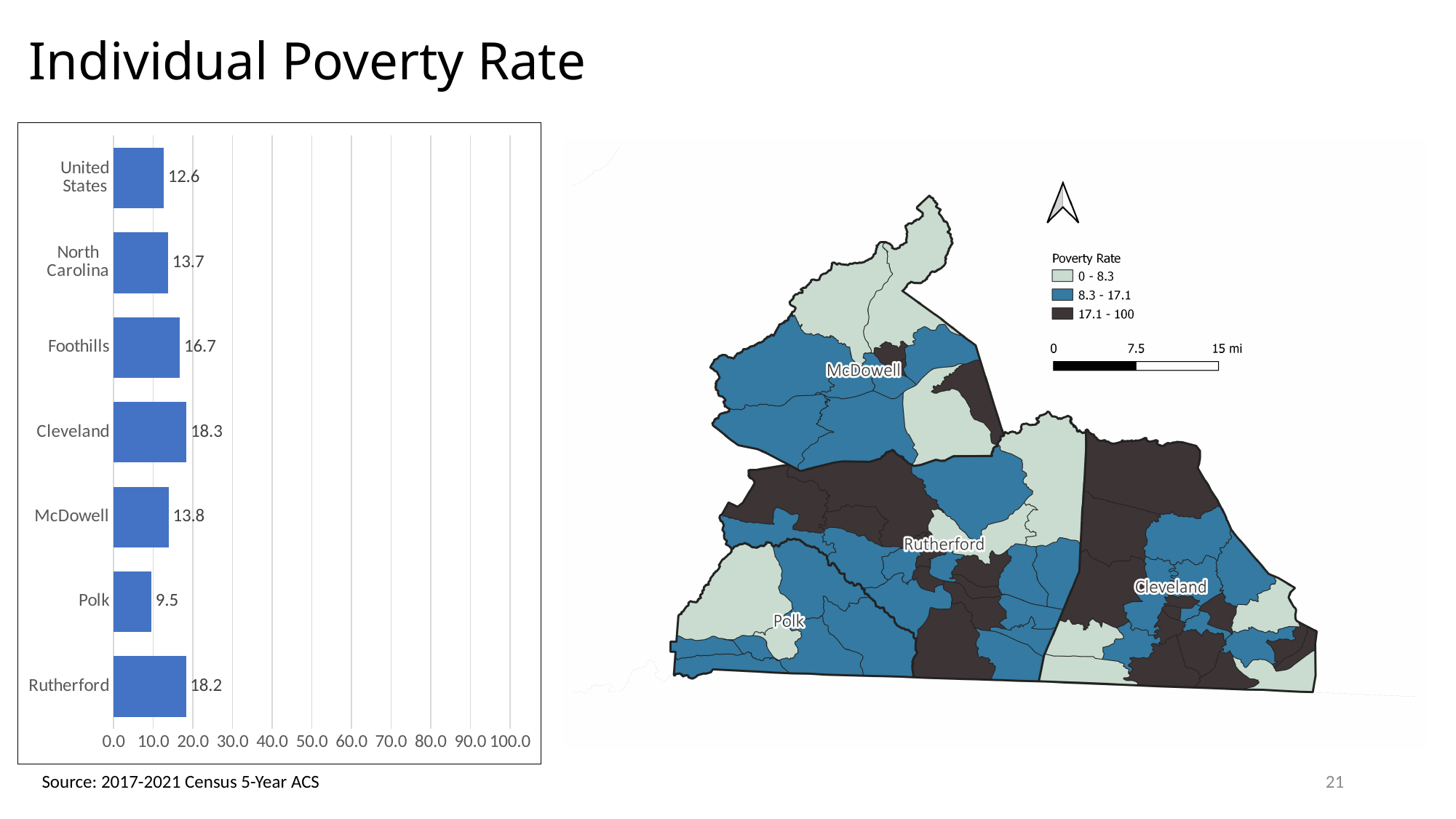
How many categories are shown in the bar chart? 7 Is the value for Polk in the bar chart greater or less than 10.0? less What is the individual poverty rate shown for Cleveland in the bar chart? 18.3 What is the value for Foothills in the bar chart? 16.7 In the bar chart, which is larger: the value for Foothills or the value for McDowell? Foothills Which category has the lowest value in the bar chart? Polk What is the highest value shown on the x axis of the bar chart? 100.0 What value does the bar chart show for the United States? 12.6 What is the value for Polk in the bar chart? 9.5 What is the difference between the values for Cleveland and Polk in the bar chart? 8.8 What kind of chart is shown on the left of the slide? Bar chart What is the difference between the values for Rutherford and the United States in the bar chart? 5.6